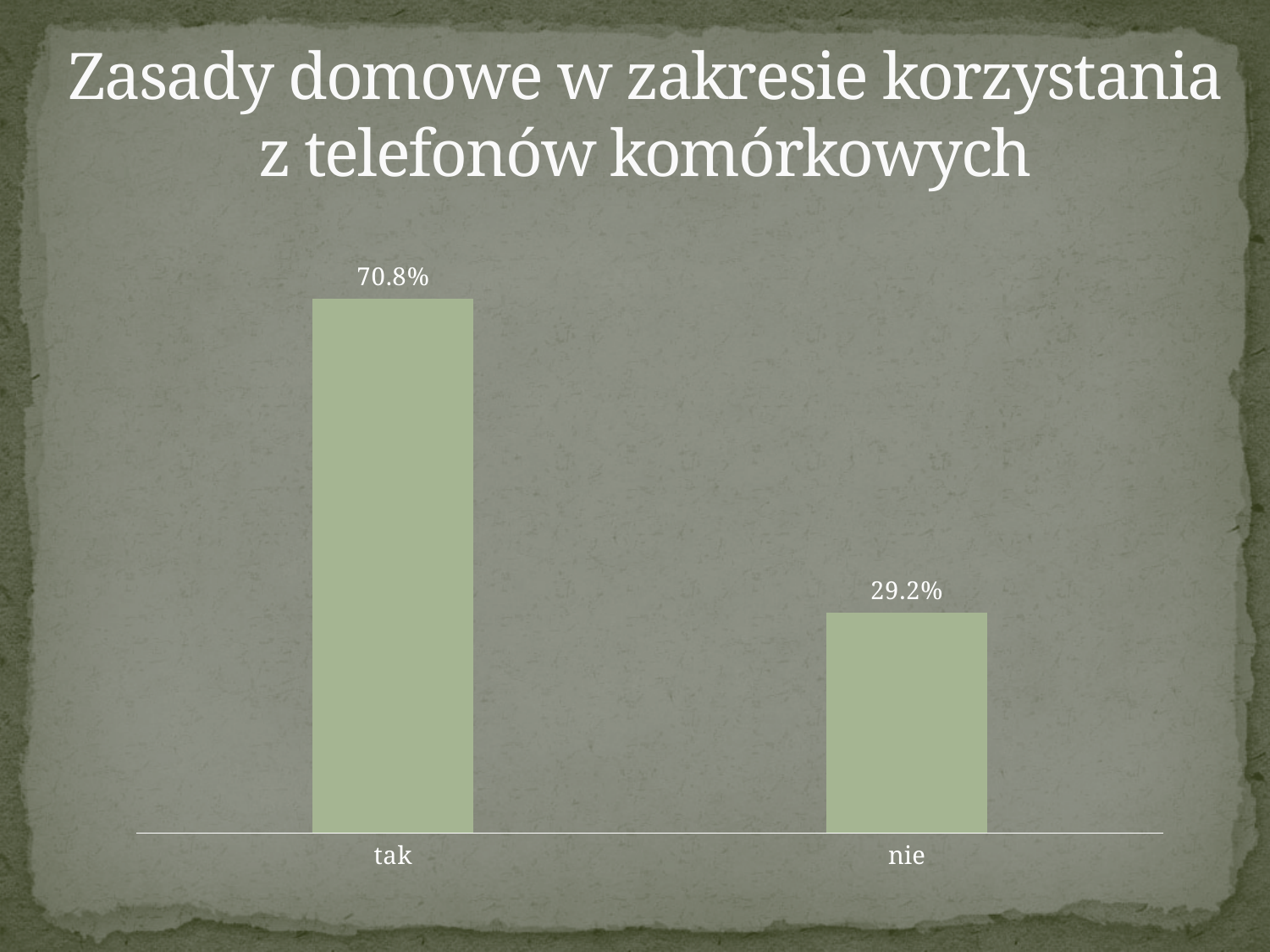
Do the values rise or fall from left to right along the x axis? fall What kind of chart is shown on the slide? bar chart What is the value for "nie"? 29.2% What is the difference between the values for "tak" and "nie"? 41.6% Which category has the highest value? tak Which is larger, the value for "tak" or the value for "nie"? tak What is the total of the two values shown on the chart? 100% What is the value for "tak"? 70.8% How many categories are shown on the chart? 2 Which category has the lowest value? nie What is the title of the slide? Zasady domowe w zakresie korzystania z telefonów komórkowych